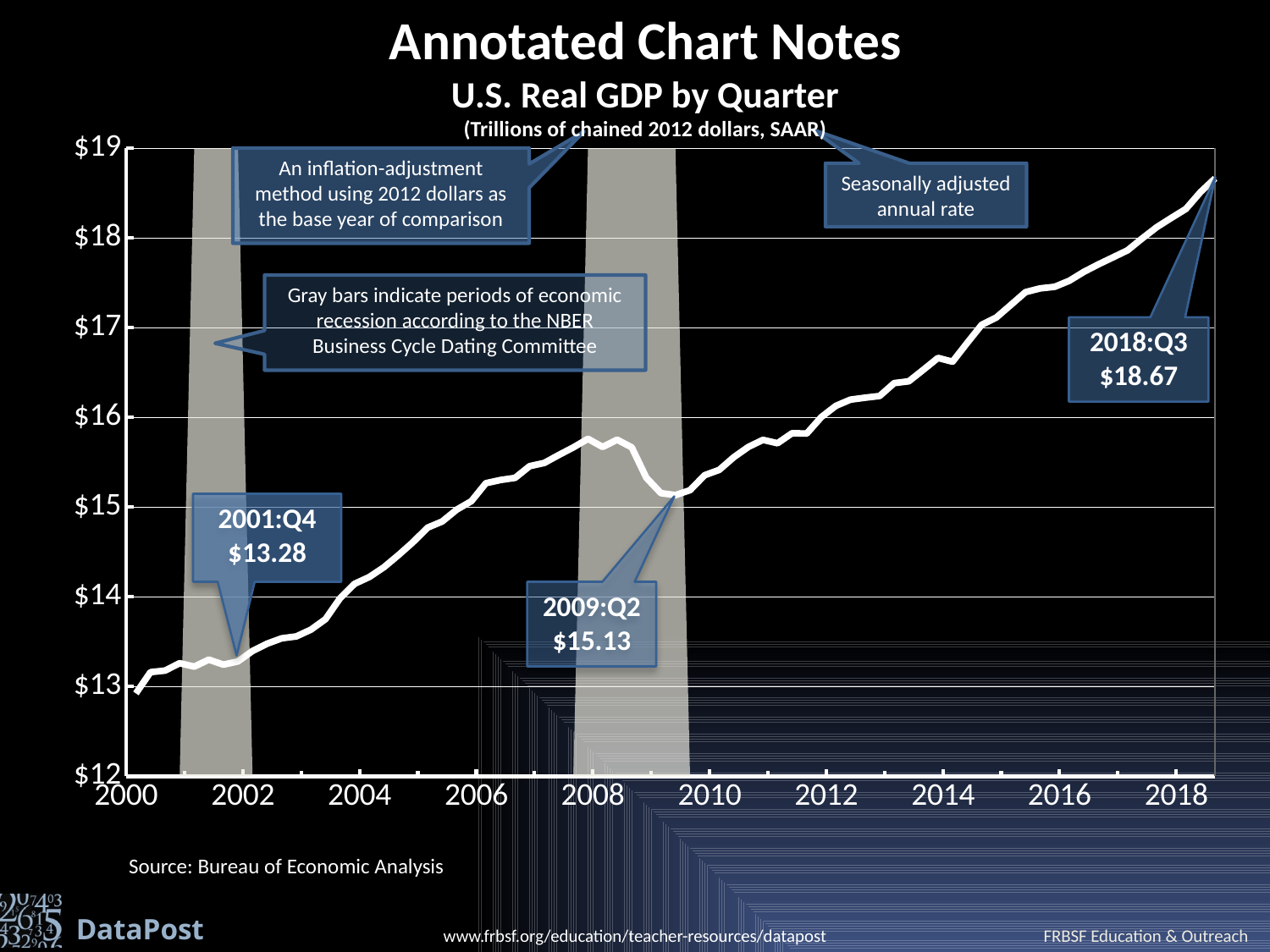
What is the value of U.S. Real GDP labeled for 2009:Q2? $15.13 What is the value of U.S. Real GDP labeled for 2018:Q3? $18.67 Which labeled point has the higher value, 2001:Q4 or 2009:Q2? 2009:Q2 What is the difference between the labeled values for 2009:Q2 and 2001:Q4? $1.85 Of the three labeled points on the chart, which has the highest value? 2018:Q3 Is the value of real GDP in 2016 greater or less than $17? greater According to the annotation, what do the gray bars on the chart indicate? Periods of economic recession according to the NBER Business Cycle Dating Committee What is the difference between the labeled values for 2018:Q3 and 2009:Q2? $3.54 What is the value of U.S. Real GDP labeled for 2001:Q4? $13.28 Is the value of real GDP in 2010 greater or less than $16? less Does U.S. Real GDP generally rise or fall from 2000 to 2018? rise What kind of chart is shown on the slide? line chart